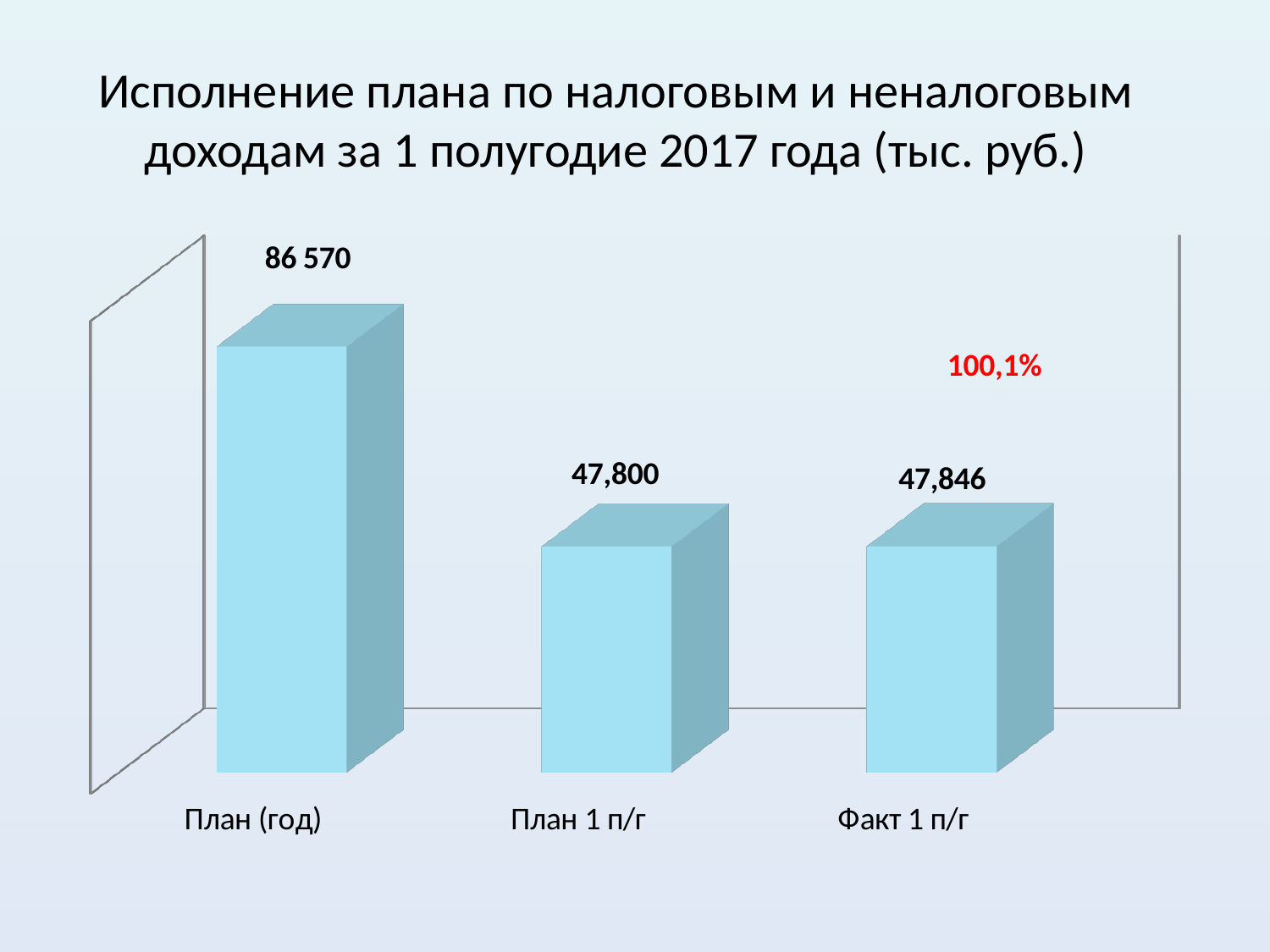
What is the value for План (год)? 86 570 Which is larger, the value for План (год) or the value for Факт 1 п/г? План (год) What is the value for План 1 п/г? 47,800 What percentage is printed in red on the chart? 100,1% What is the title of the chart? Исполнение плана по налоговым и неналоговым доходам за 1 полугодие 2017 года (тыс. руб.) What is the value for Факт 1 п/г? 47,846 What is the difference between the value for План (год) and the value for План 1 п/г? 38,770 Which category has the highest value? План (год) What kind of chart is shown on the slide? Bar chart What is the difference between the value for Факт 1 п/г and the value for План 1 п/г? 46 How many categories are shown on the chart? 3